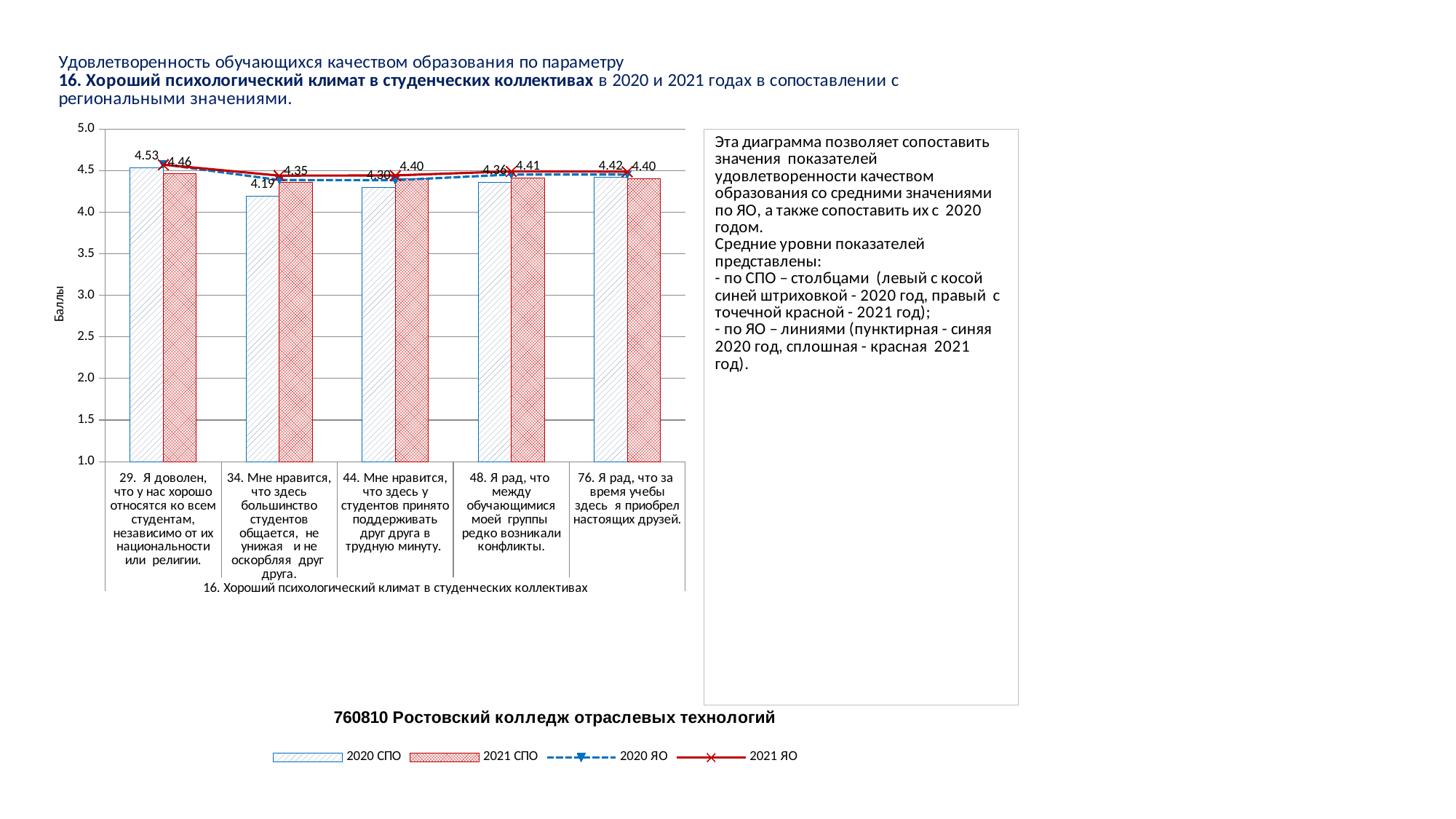
Is the 2021 ЯО line value for category 34 greater or less than 4.0? greater Which category has the highest 2020 СПО value? 29. Я доволен, что у нас хорошо относятся ко всем студентам, независимо от их национальности или религии. How many categories are shown on the x axis? 5 What is the 2020 СПО value for category 29 (Я доволен, что у нас хорошо относятся ко всем студентам)? 4.53 What is the 2021 СПО value for category 34 (Мне нравится, что здесь большинство студентов общается, не унижая и не оскорбляя друг друга)? 4.35 Which category has the lowest 2020 СПО value? 34. Мне нравится, что здесь большинство студентов общается, не унижая и не оскорбляя друг друга. What is the 2021 СПО value for category 48 (Я рад, что между обучающимися моей группы редко возникали конфликты)? 4.41 What is the label of the vertical axis? Баллы What is the difference between the 2021 СПО and 2020 СПО values for category 34? 0.16 For category 76 (Я рад, что за время учебы здесь я приобрел настоящих друзей), which is larger: the 2020 СПО value or the 2021 СПО value? 2020 СПО What kind of chart is this? Combined bar and line chart How many series does the legend list? 4